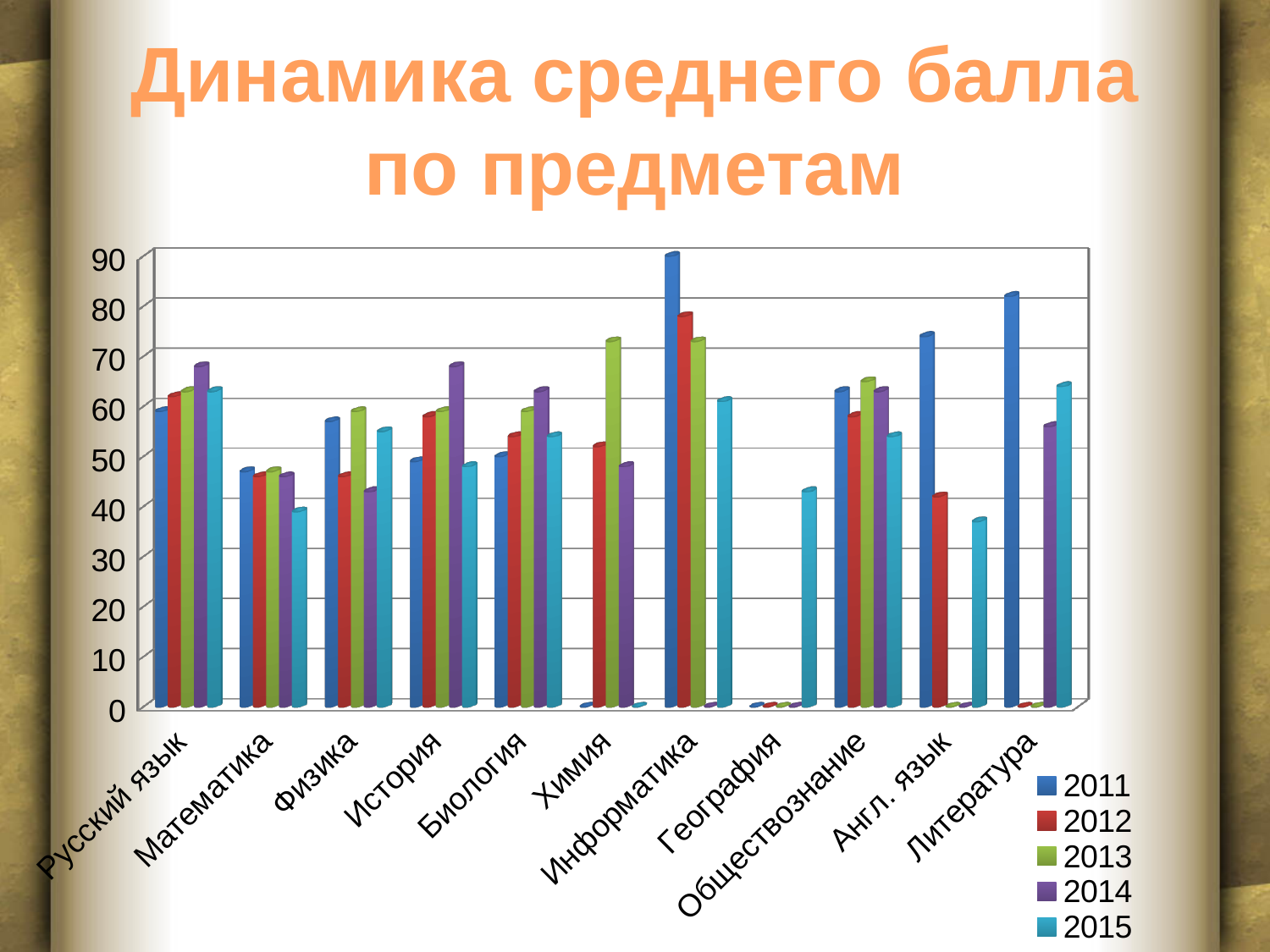
For Англ. язык, which is larger: the 2011 value or the 2012 value? 2011 Is the 2011 value for Литература greater or less than 70? greater Is the 2011 value for Информатика greater or less than 80? greater How many subject categories are shown on the x axis? 11 For Физика, which is larger: the 2013 value or the 2014 value? 2013 Is the 2015 value for Математика greater or less than 50? less Which subject has the tallest bar in the chart? Информатика Which year is the only one with a bar for География? 2015 What kind of chart is shown on the slide? bar chart How many series does the legend list? 5 For Русский язык, which is larger: the 2011 value or the 2014 value? 2014